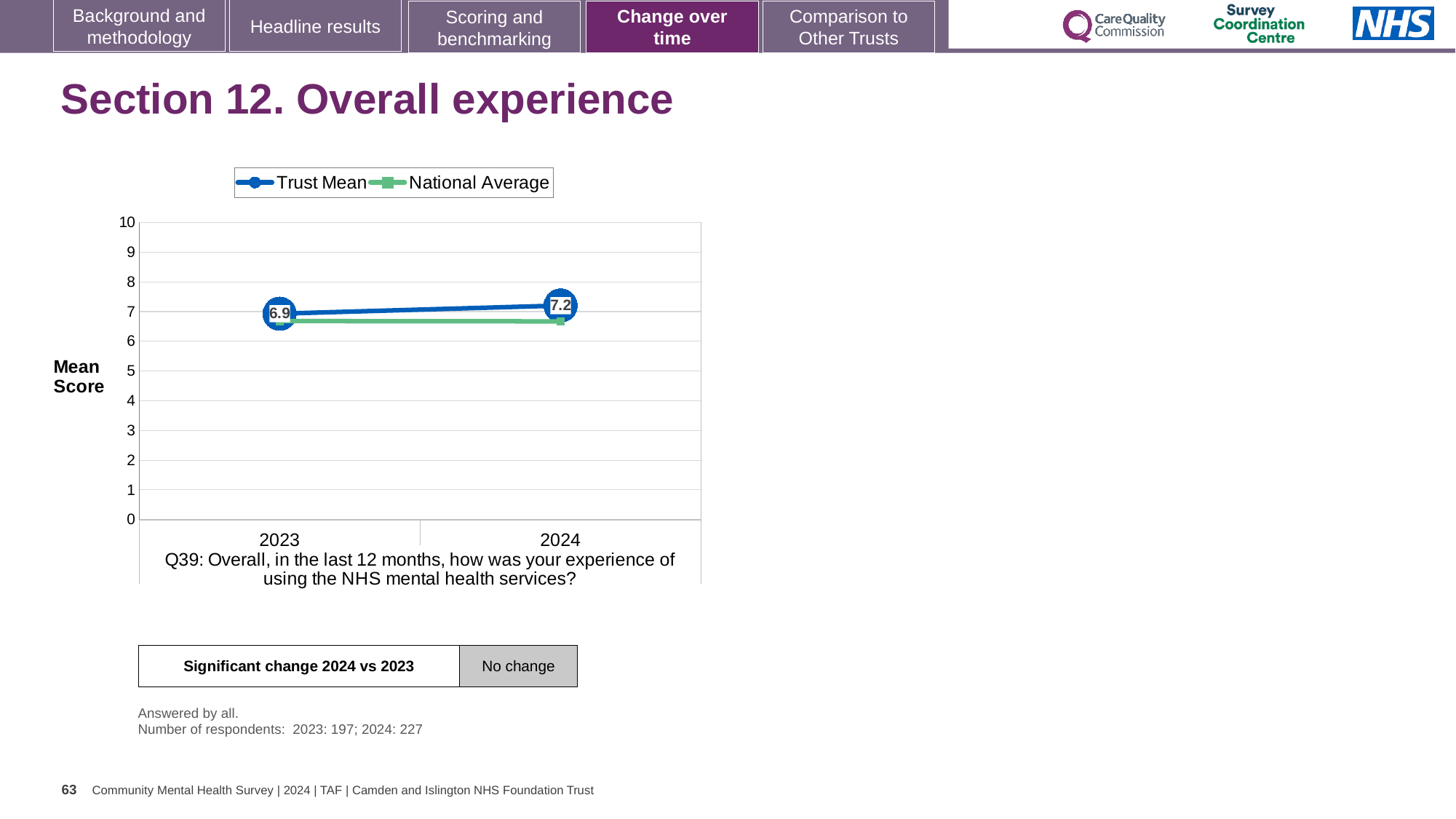
How many series does the legend list? 2 What kind of chart is shown on the slide? line chart What is the Trust Mean value for 2024? 7.2 Is the National Average value for 2023 greater or less than 6? greater Which is larger in 2024, the Trust Mean or the National Average? Trust Mean How many years are plotted on the x axis? 2 What is the Trust Mean value for 2023? 6.9 Does the Trust Mean rise or fall from 2023 to 2024? rise In which year is the Trust Mean lowest? 2023 What is the label on the y axis of the chart? Mean Score In which year is the Trust Mean highest? 2024 What is the difference between the Trust Mean in 2024 and in 2023? 0.3